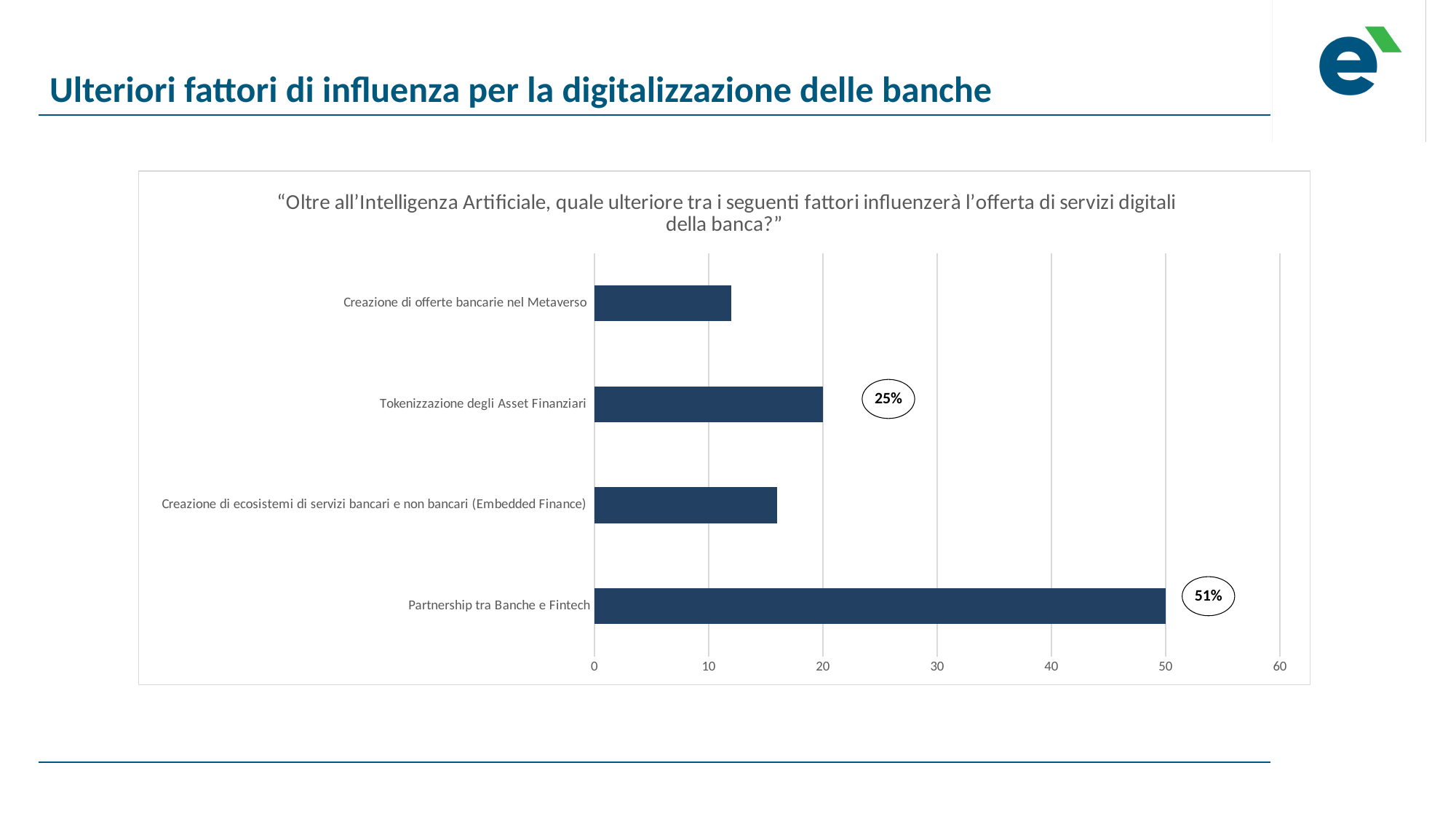
What percentage is shown in the circled callout next to the Partnership tra Banche e Fintech bar? 51% What kind of chart is shown on the slide? bar chart What percentage is shown in the circled callout next to the Tokenizzazione degli Asset Finanziari bar? 25% Which factor has the longest bar in the chart? Partnership tra Banche e Fintech Is the bar for Creazione di offerte bancarie nel Metaverso greater or less than 20? less What is the maximum value shown on the horizontal axis of the chart? 60 Is the bar for Creazione di ecosistemi di servizi bancari e non bancari (Embedded Finance) greater or less than 10? greater How many categories (factors) are plotted in the chart? 4 Which bar is longer: Tokenizzazione degli Asset Finanziari or Creazione di ecosistemi di servizi bancari e non bancari (Embedded Finance)? Tokenizzazione degli Asset Finanziari Which factor has the shortest bar in the chart? Creazione di offerte bancarie nel Metaverso Is the bar for Partnership tra Banche e Fintech greater or less than 40? greater Which bar is longer: Creazione di offerte bancarie nel Metaverso or Partnership tra Banche e Fintech? Partnership tra Banche e Fintech